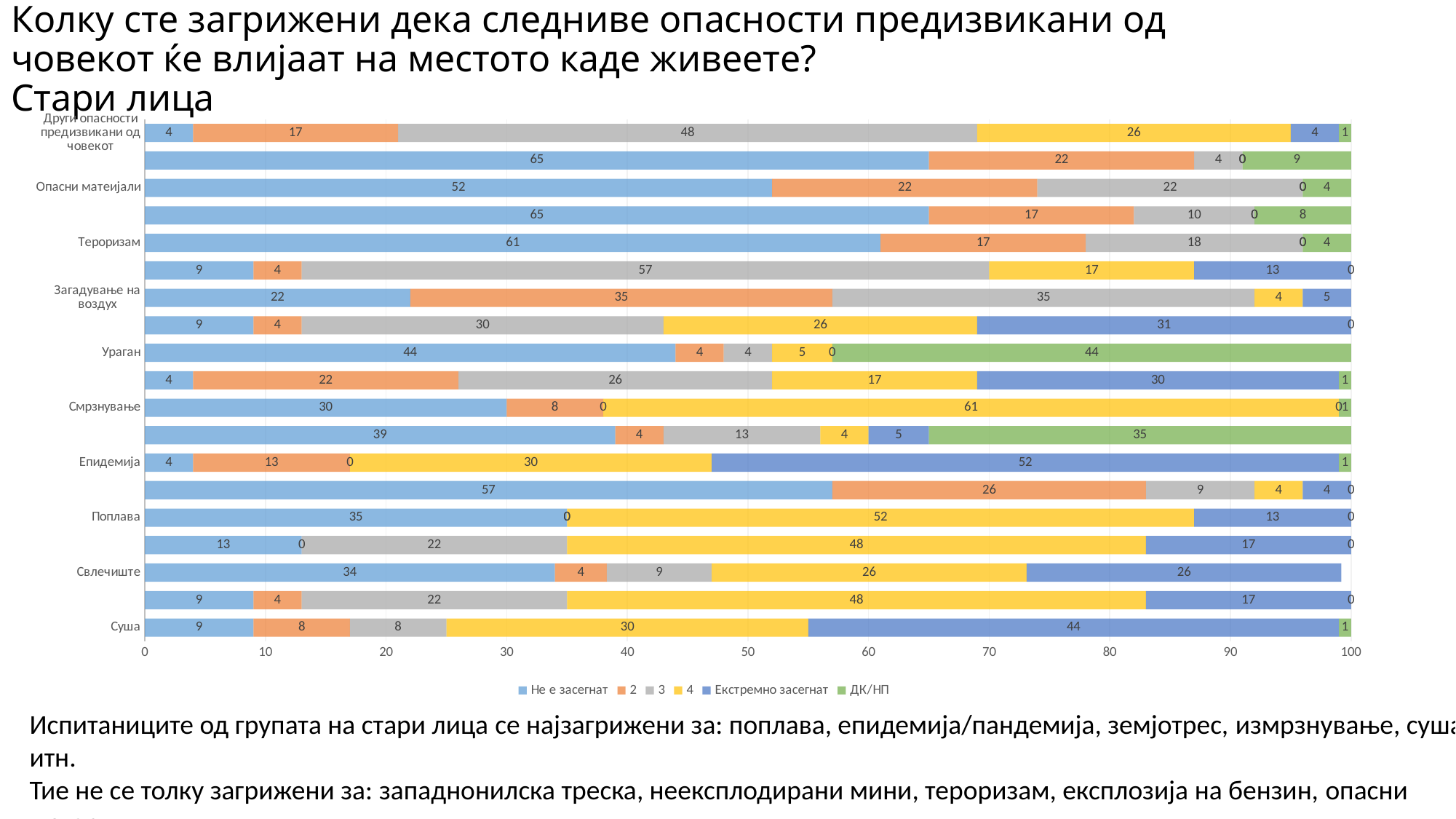
What is the value of 'Екстремно засегнат' for Епидемија? 52 For Суша, which series has the largest segment? Екстремно засегнат What is the value of series '2' for Загадување на воздух? 35 What is the value of series '4' for Смрзнување? 61 What is the value of 'Не е засегнат' for Тероризам? 61 Which has a larger 'Не е засегнат' value, Тероризам or Поплава? Тероризам What is the value of 'Екстремно засегнат' for Суша? 44 What is the difference between the 'Екстремно засегнат' values for Епидемија and Суша? 8 How many series does the legend list? 6 What is the value of 'Не е засегнат' for Свлечиште? 34 What kind of chart is shown on the slide? Stacked bar chart What is the value of 'ДК/НП' for Ураган? 44